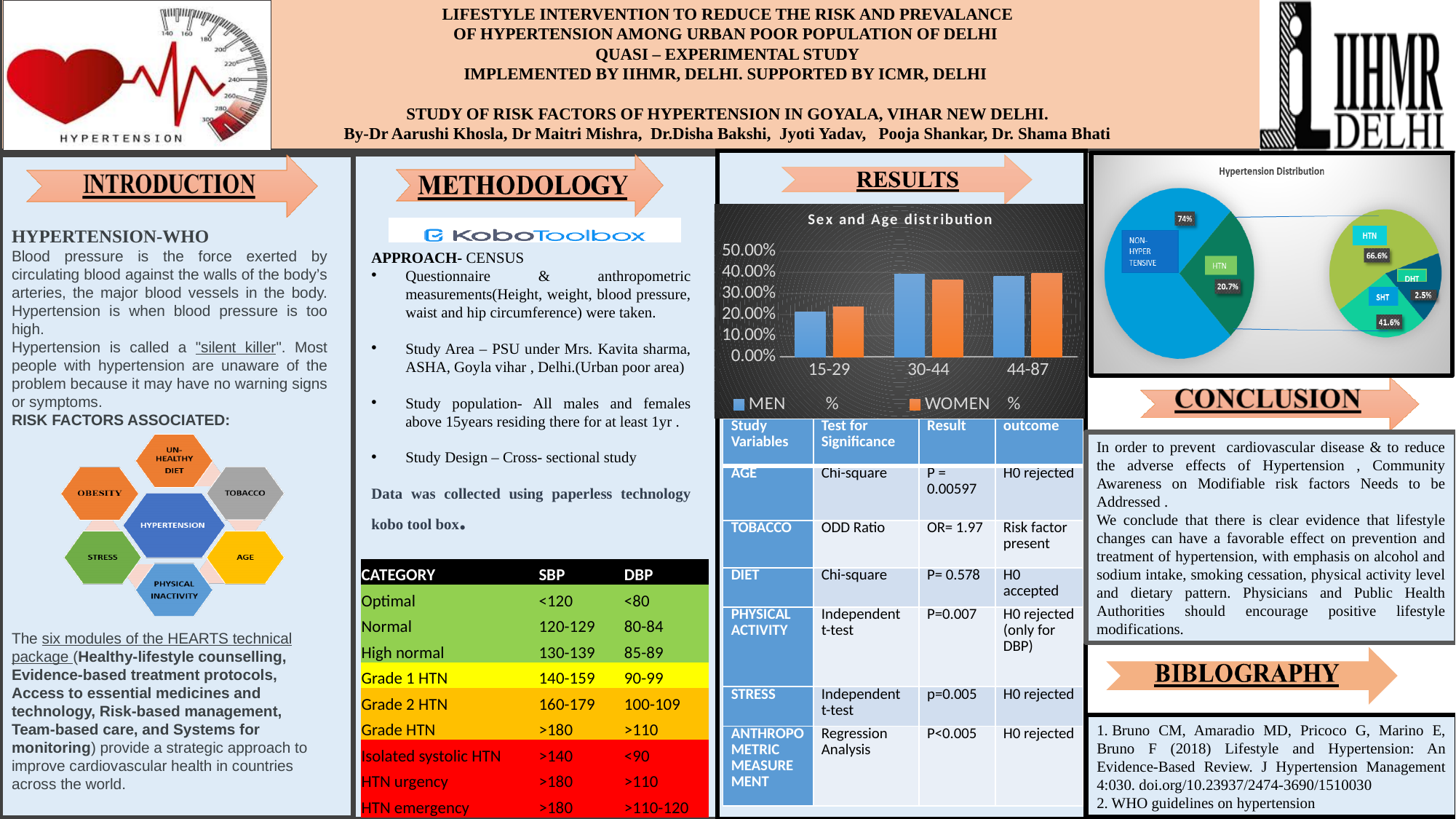
How many series does the legend of the 'Sex and Age distribution' chart list? 2 In the 'Sex and Age distribution' chart, is the MEN value for the 30-44 age group greater or less than 30.00%? greater In the 'Sex and Age distribution' chart, is the MEN value for the 15-29 age group greater or less than 30.00%? less In the 'Sex and Age distribution' chart, which is larger for the 30-44 age group, the MEN value or the WOMEN value? MEN In the 'Sex and Age distribution' chart, is the WOMEN value for the 44-87 age group greater or less than 30.00%? greater How many age groups are shown on the x axis of the 'Sex and Age distribution' chart? 3 What kind of chart is the 'Sex and Age distribution' chart? bar chart What is the title of the bar chart in the RESULTS section? Sex and Age distribution In the 'Sex and Age distribution' chart, which age group has the lowest WOMEN value? 15-29 In the 'Hypertension Distribution' pie chart on the right, what share is labelled DHT? 2.5% In the 'Sex and Age distribution' chart, which age group has the lowest MEN value? 15-29 In the 'Hypertension Distribution' pie chart on the right, what share is labelled NON-HYPERTENSIVE? 74%